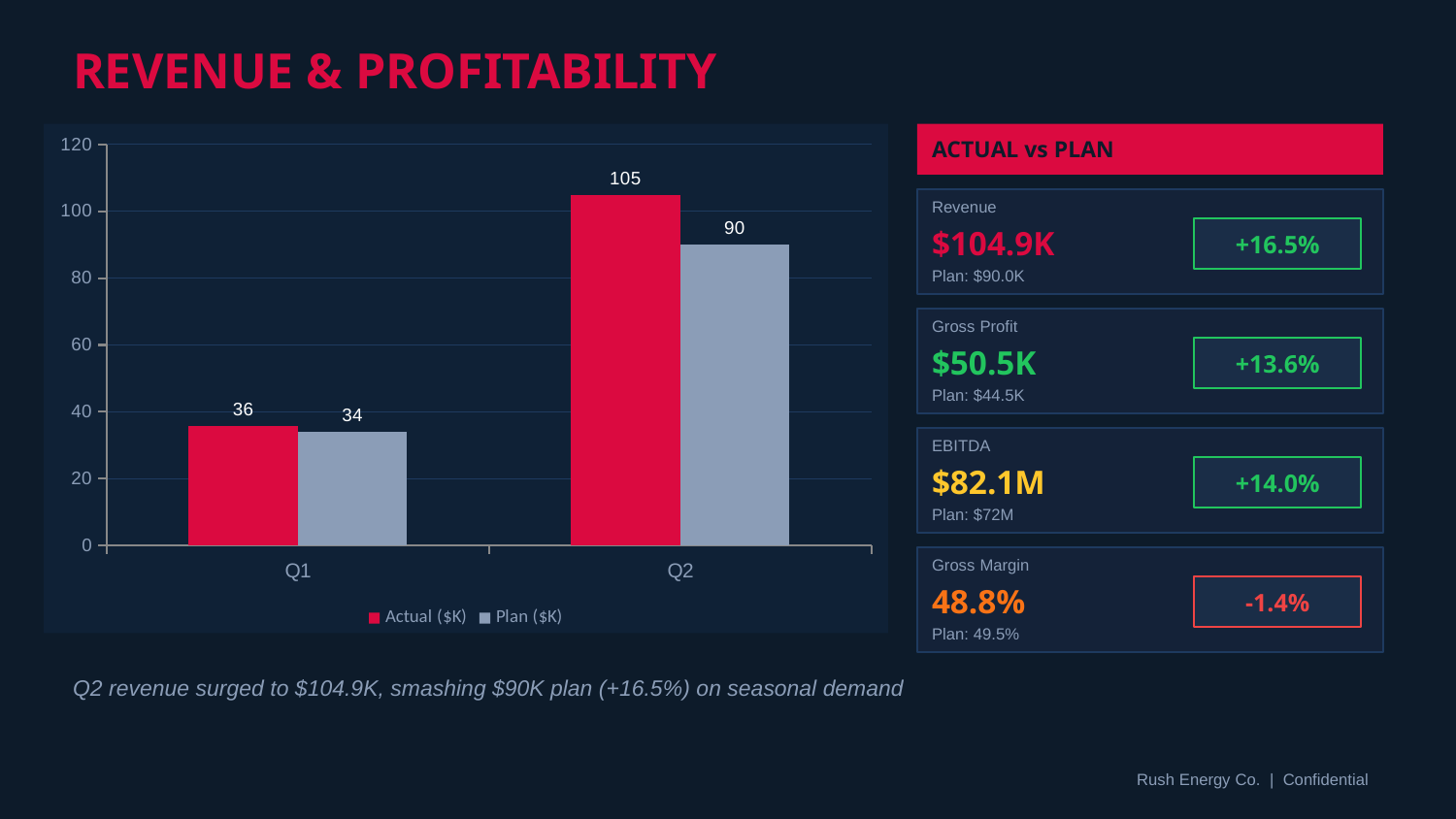
What is the Actual ($K) value for Q1? 36 Which quarter has the highest Actual ($K) value? Q2 How many categories are shown on the x axis? 2 Which quarter has the lowest Plan ($K) value? Q1 Which is larger for Q1: the Actual ($K) value or the Plan ($K) value? Actual ($K) What is the difference between the Actual ($K) and Plan ($K) values for Q2? 15 What is the Plan ($K) value for Q1? 34 What is the Actual ($K) value for Q2? 105 How many series does the legend list? 2 What is the Plan ($K) value for Q2? 90 Is the Actual ($K) value for Q2 greater or less than 100? greater What kind of chart is shown on the slide? Bar chart